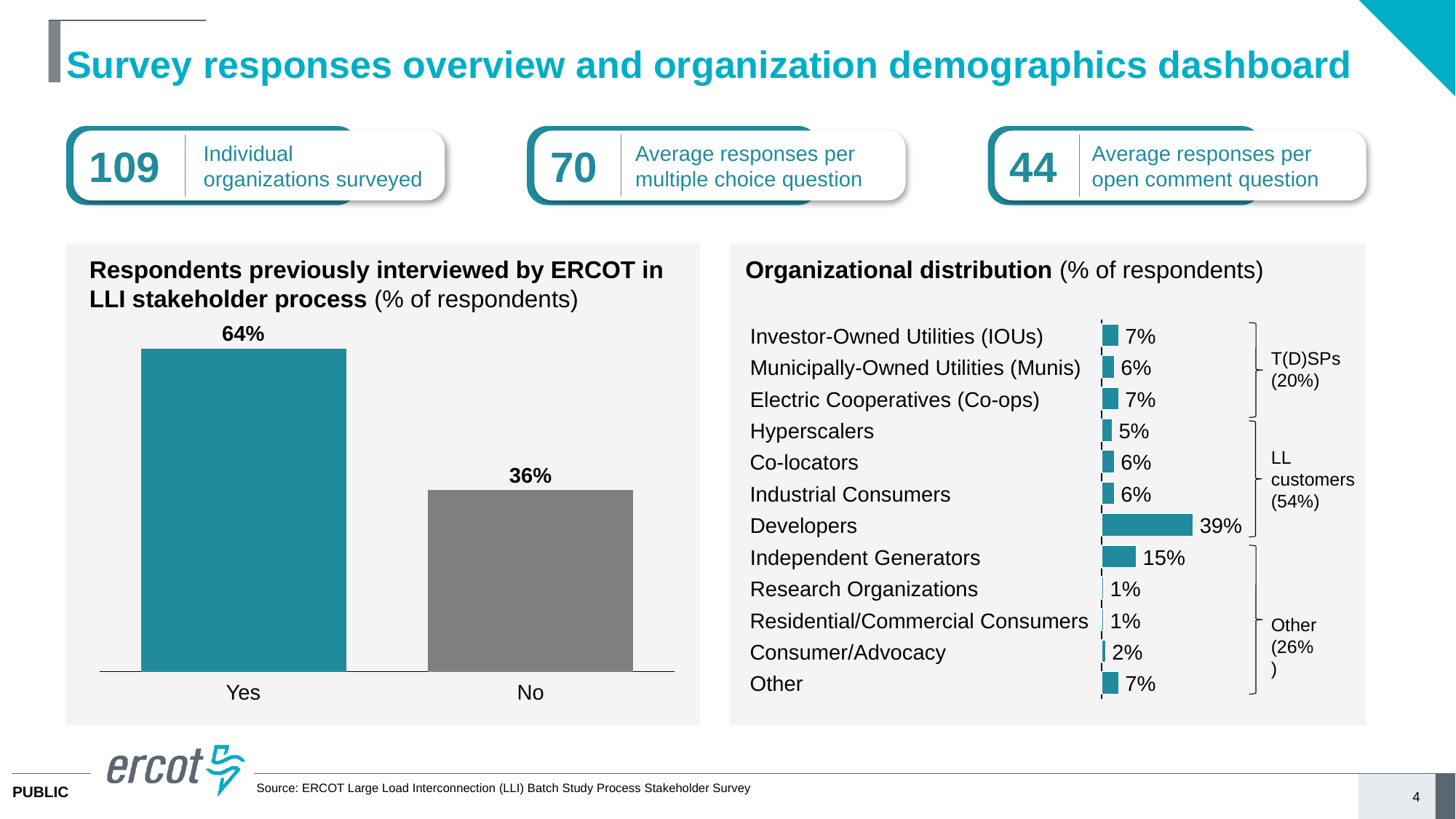
In the 'Organizational distribution' chart, what percentage of respondents are Consumer/Advocacy? 2% In the 'Organizational distribution' chart, which category has the highest percentage of respondents? Developers In the 'Organizational distribution' chart, what share of respondents does the LL customers group account for? 54% In the 'Organizational distribution' chart, what percentage of respondents are Independent Generators? 15% In the 'Organizational distribution' chart, what is the difference between Developers and Independent Generators? 24% In the 'Organizational distribution' chart, what percentage of respondents are Developers? 39% In the 'Respondents previously interviewed by ERCOT in LLI stakeholder process' chart, what percentage of respondents answered No? 36% In the 'Respondents previously interviewed by ERCOT in LLI stakeholder process' chart, what is the difference between the Yes and No percentages? 28% What kind of chart is the 'Respondents previously interviewed by ERCOT in LLI stakeholder process' chart? Bar chart In the 'Organizational distribution' chart, which is larger: Hyperscalers or Independent Generators? Independent Generators In the 'Organizational distribution' chart, how many categories are plotted? 12 In the 'Respondents previously interviewed by ERCOT in LLI stakeholder process' chart, what percentage of respondents answered Yes? 64%